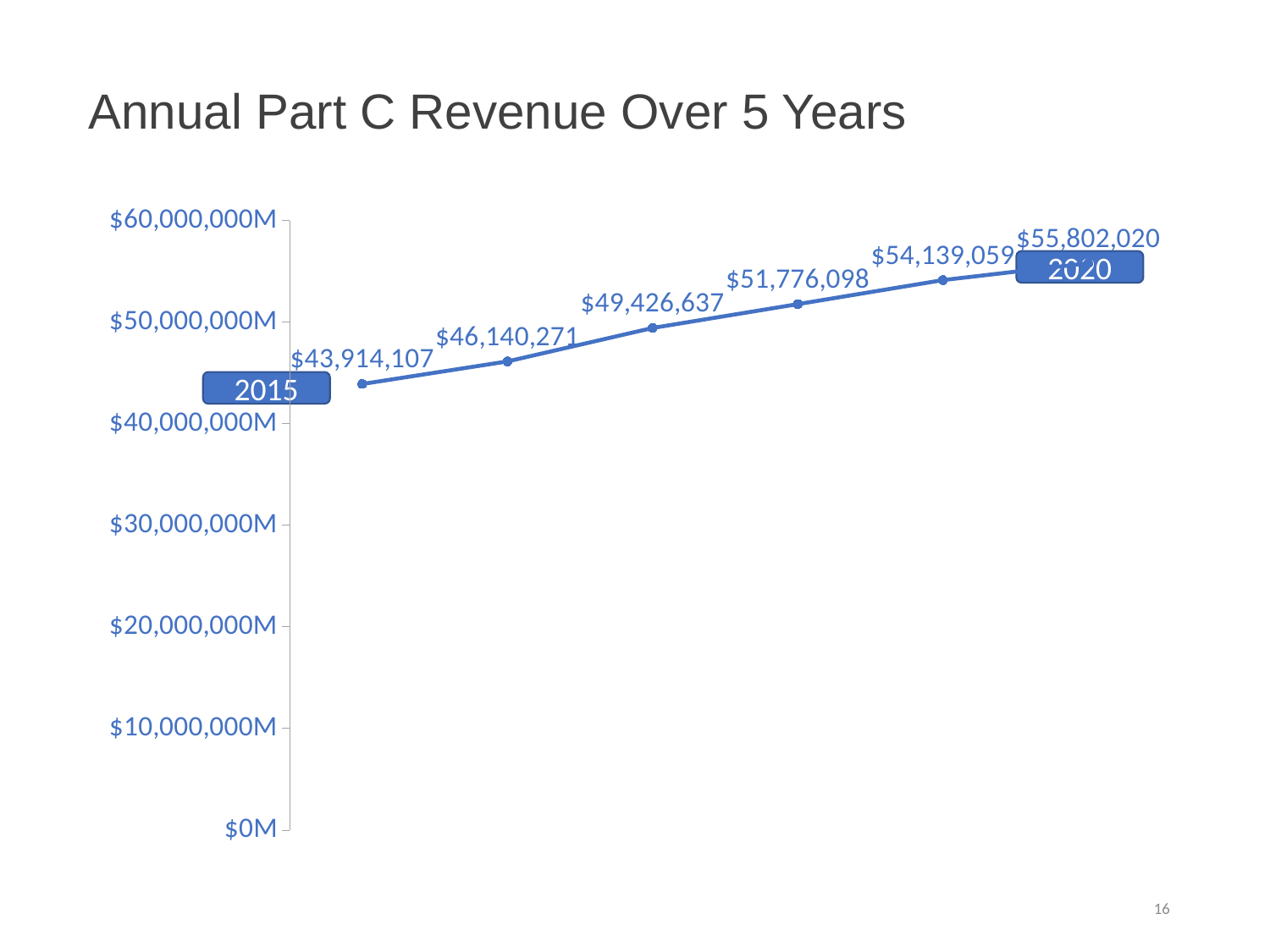
What is the revenue value labeled for 2015? $43,914,107 What kind of chart is shown on the slide? line chart What is the value of the second data point on the line? $46,140,271 Do the revenue values rise or fall from 2015 to 2020? rise What is the revenue value labeled for 2020? $55,802,020 What is the value of the fifth data point on the line? $54,139,059 What is the value of the fourth data point on the line? $51,776,098 What is the difference between the 2020 revenue and the 2015 revenue? $11,887,913 How many data points are plotted on the line? 6 What is the title of the chart? Annual Part C Revenue Over 5 Years Which year has the lowest revenue? 2015 Which year has the highest revenue? 2020